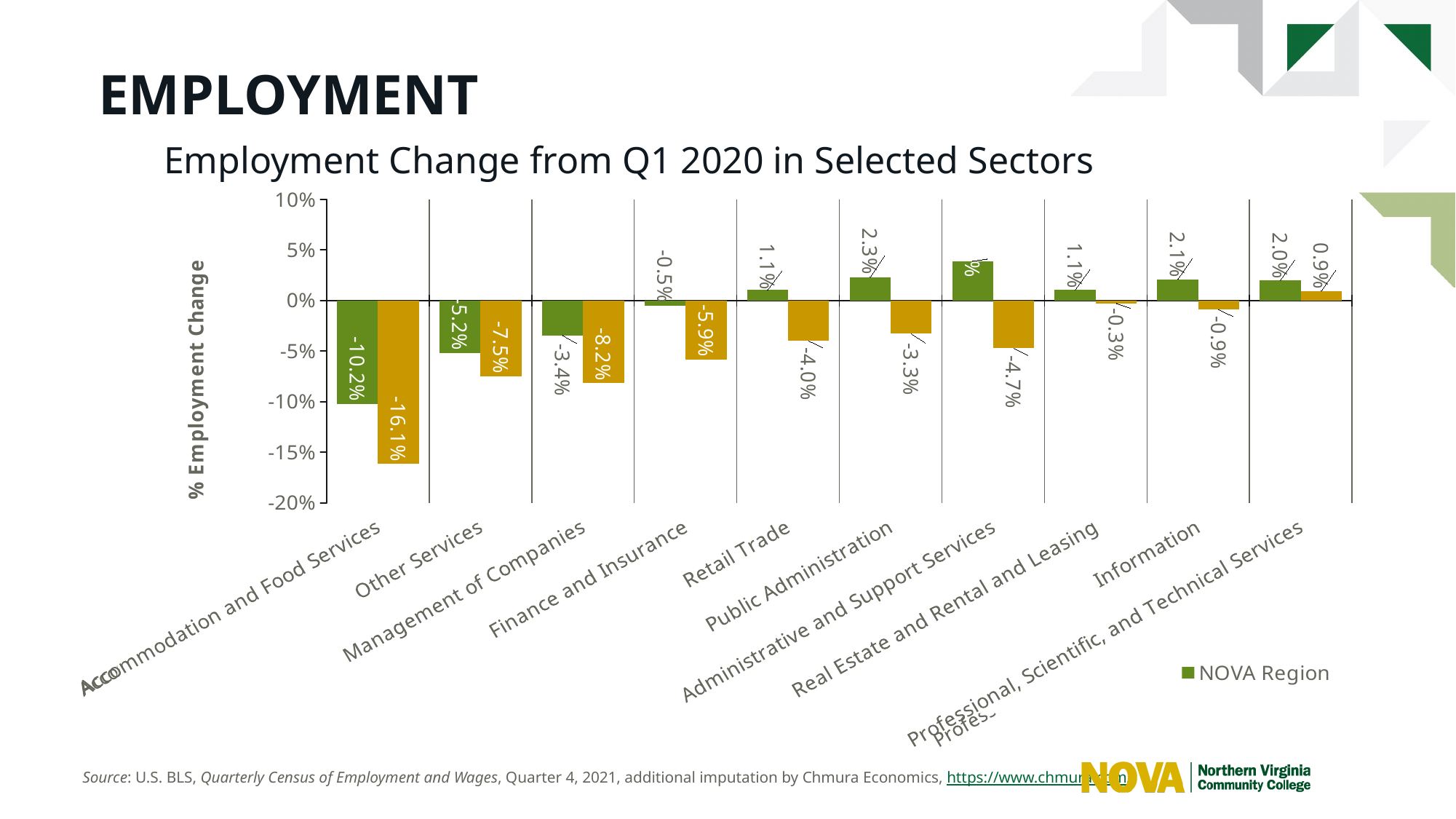
What is the NOVA Region employment change for Accommodation and Food Services? -10.2% How many sectors are shown on the x axis of the chart? 10 What is the value of the gold bar for Accommodation and Food Services? -16.1% Is the gold bar value for Finance and Insurance greater or less than -5%? less Which sector has the lowest NOVA Region employment change? Accommodation and Food Services For Other Services, what is the difference between the NOVA Region value (-5.2%) and the gold bar value (-7.5%)? 2.3 percentage points For Management of Companies, which is larger: the NOVA Region value or the gold bar value? NOVA Region What type of chart is used to show employment change by sector? bar chart What is the value of the gold bar for Professional, Scientific, and Technical Services? 0.9% What is the value of the gold bar for Retail Trade? -4.0% Which sector has the highest NOVA Region employment change? Administrative and Support Services What is the NOVA Region employment change for Public Administration? 2.3%